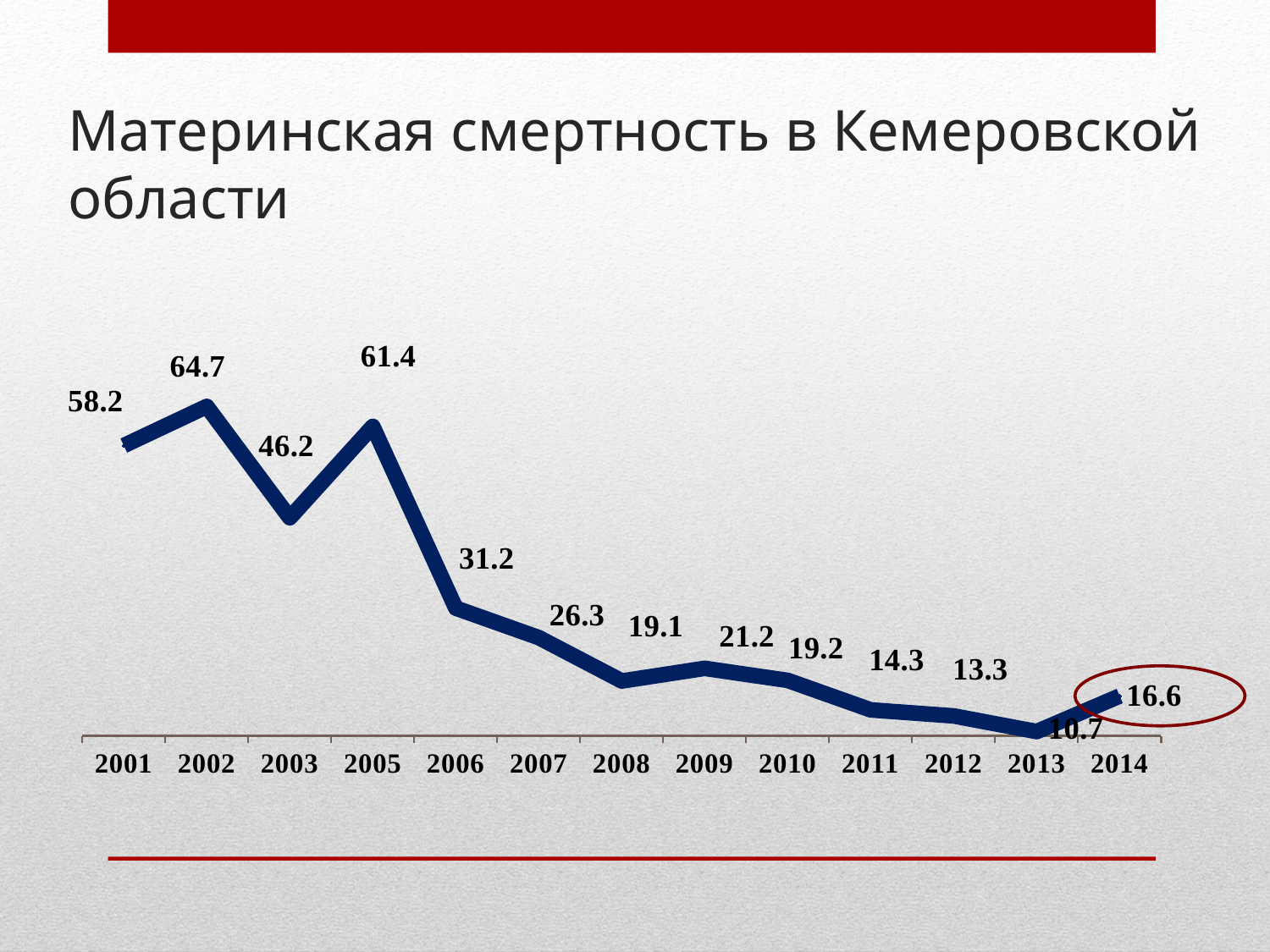
What is the difference between the values for 2014 and 2013? 5.9 What is the value for 2014? 16.6 Overall, do the values rise or fall from 2001 to 2014? fall What is the value for 2006? 31.2 Which year has the highest value? 2002 What is the value for 2001? 58.2 How many years are plotted on the chart? 13 What is the difference between the values for 2002 and 2003? 18.5 What is the title of the slide? Материнская смертность в Кемеровской области Which year has the lowest value? 2013 Which is larger, the value for 2005 or the value for 2001? 2005 What type of chart is shown on the slide? line chart